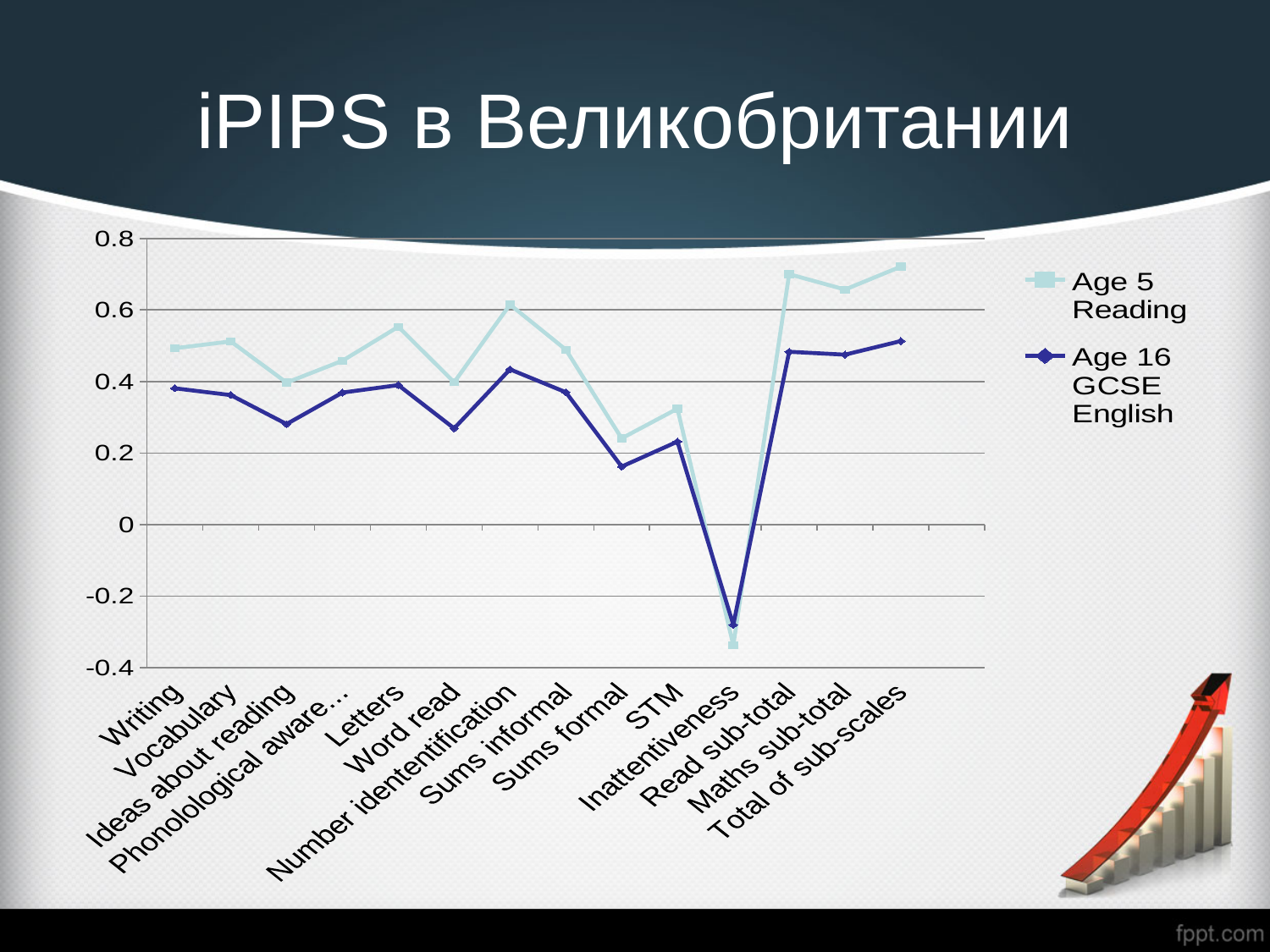
Does the Age 5 Reading line rise or fall from STM to Inattentiveness? fall For which category is the Age 5 Reading value lowest? Inattentiveness What kind of chart is shown on the slide? line chart For which category is the Age 16 GCSE English value lowest? Inattentiveness What are the two series named in the legend? Age 5 Reading; Age 16 GCSE English For Letters, which series has the higher value: Age 5 Reading or Age 16 GCSE English? Age 5 Reading Is the Age 5 Reading value for Read sub-total greater or less than 0.6? greater Is the Age 5 Reading value for Sums formal greater or less than 0.4? less How many series does the legend list? 2 How many categories are plotted along the x axis? 14 Is the Age 16 GCSE English value for Inattentiveness greater or less than -0.2? less